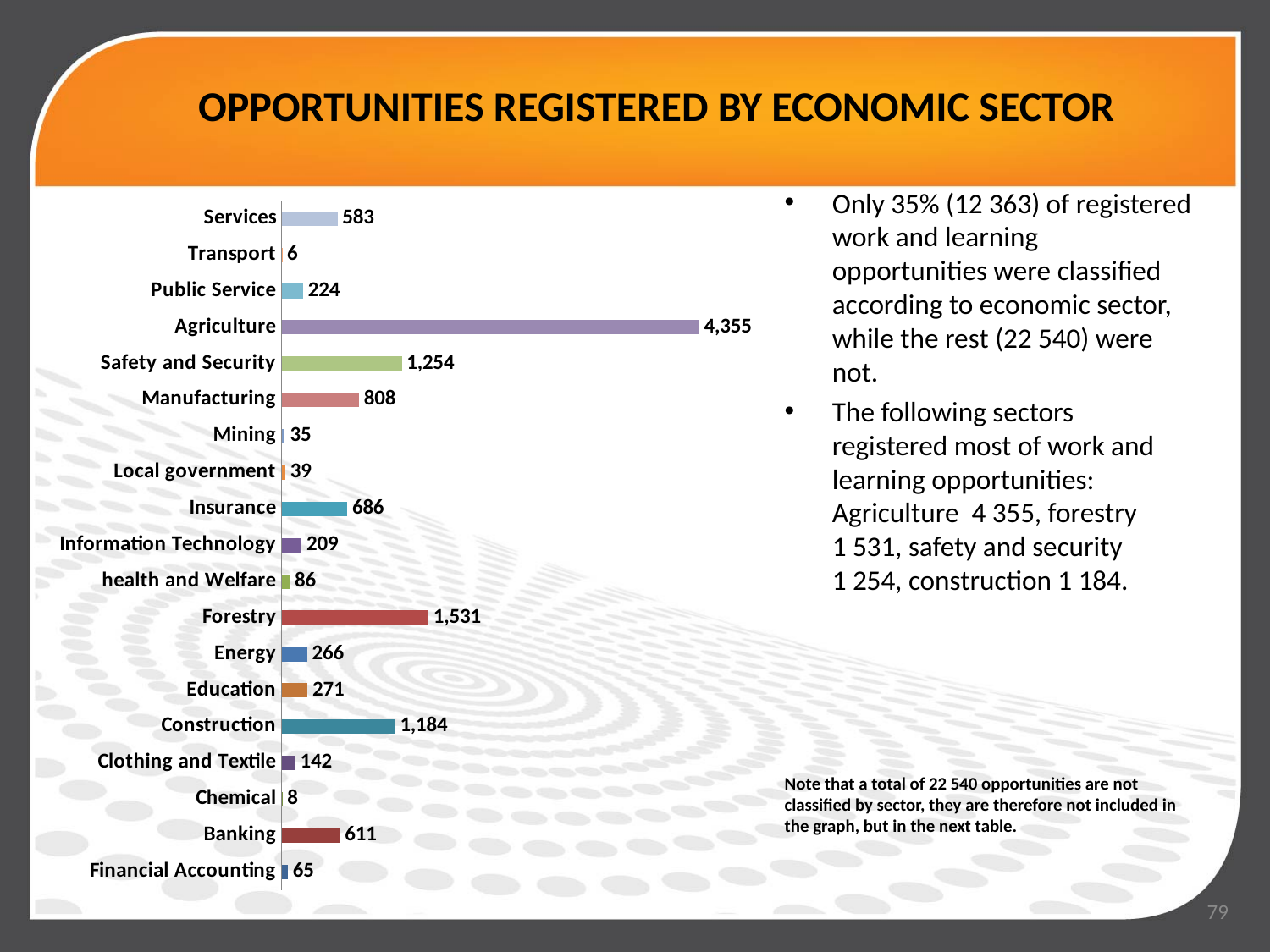
What is the value shown for Insurance? 686 What is the value shown for Construction? 1,184 What is the value shown for Forestry? 1,531 What type of chart is shown on the slide? Bar chart What is the difference between the values for Forestry and Construction? 347 What is the title of the slide containing the chart? OPPORTUNITIES REGISTERED BY ECONOMIC SECTOR How many economic sectors are plotted in the chart? 19 Which has a larger value, Manufacturing or Banking? Manufacturing What is the value shown for Clothing and Textile? 142 Which sector has the lowest number of registered opportunities? Transport What is the difference between the values for Agriculture and Forestry? 2,824 Which sector has the highest number of registered opportunities? Agriculture